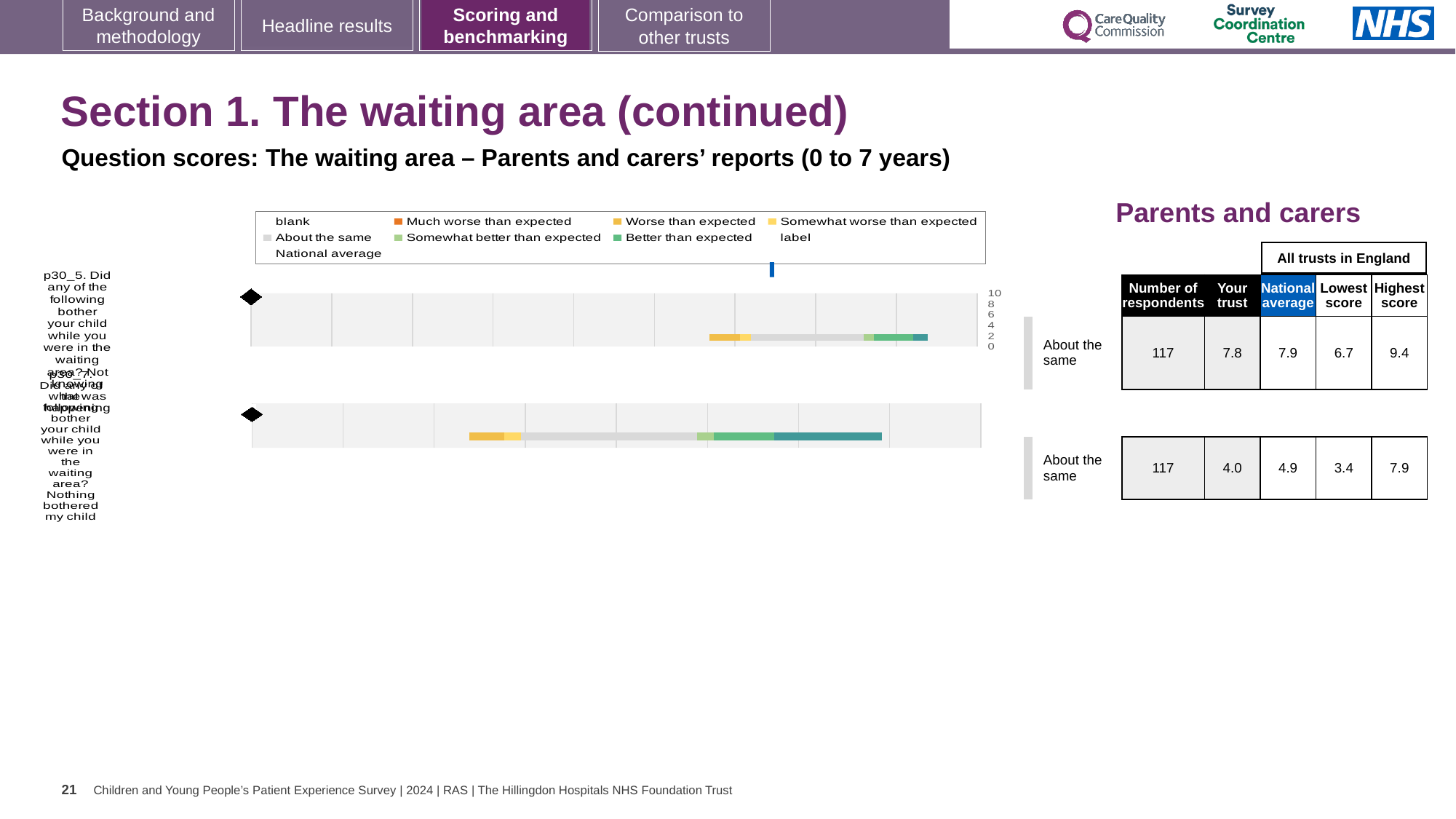
What is the national average score for the second question (p30_7, not knowing what was happening)? 4.9 What is the 'Your trust' score for the first question (p30_5, nothing bothered my child)? 7.8 How many respondents answered the first question (p30_5)? 117 How many entries does the chart legend list? 9 For the first question (p30_5), which is larger: the 'Your trust' score or the national average? National average What kind of chart is used to show the question scores on this slide? Bar chart What benchmark category is shown for the second question (p30_7)? About the same What colour does the legend use for 'Much worse than expected'? Orange Which of the two questions has the higher 'Your trust' score? p30_5 (7.8) What is the maximum value shown on the chart's score axis? 10 What is the difference between the highest score and the lowest score for the first question (p30_5)? 2.7 How many questions (bars) are plotted in the chart? 2